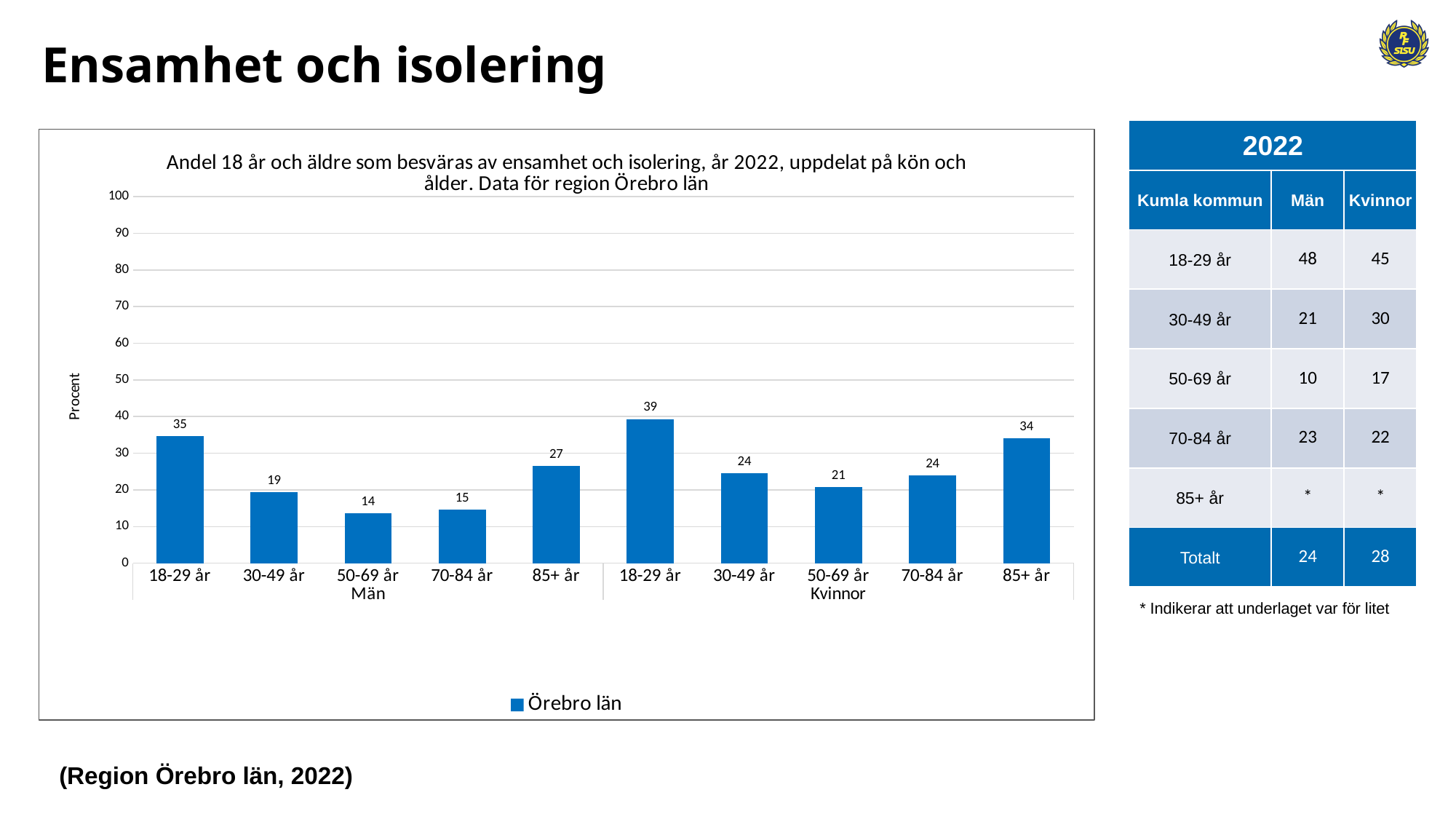
Which category has the lowest value in the chart? Män 50-69 år What is the value for Kvinnor 85+ år? 34 Which category has the highest value in the chart? Kvinnor 18-29 år What is the value for Män 50-69 år? 14 What is the difference between the values for Kvinnor 18-29 år and Män 18-29 år? 4 What is the label of the y axis? Procent What kind of chart is shown on the slide? bar chart Is the value for Kvinnor 30-49 år greater or less than 30? less How many series does the legend list? 1 What is the value for Män 18-29 år? 35 Which is larger, the value for Män 85+ år or Kvinnor 85+ år? Kvinnor 85+ år How many bars are plotted in the chart? 10